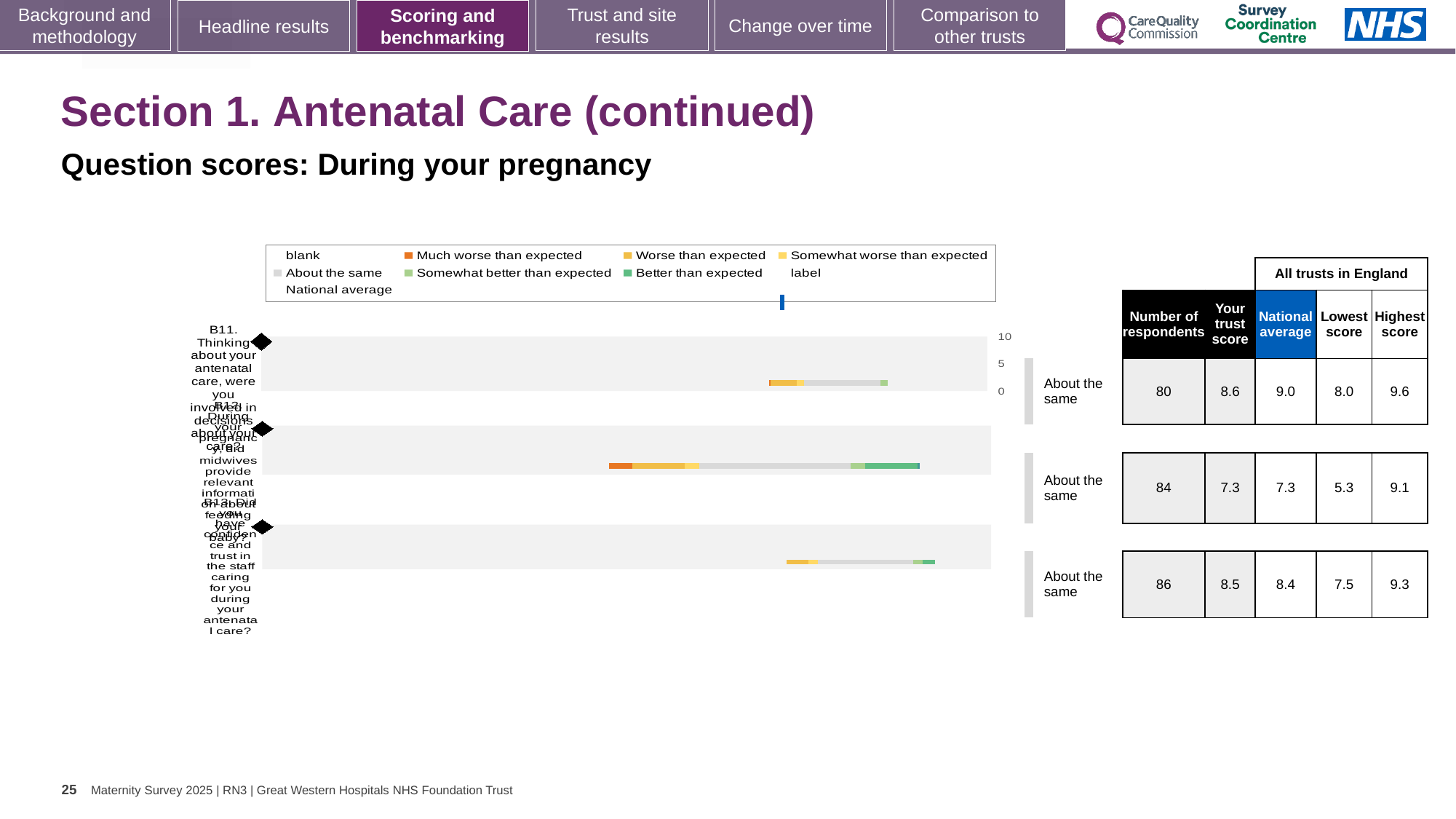
For question B13, which is larger: the trust score or the national average? the trust score What is the difference between the highest score and the lowest score for question B11? 1.6 What colour does the legend use for 'Much worse than expected'? orange What is the 'Your trust score' value for question B11 (involved in decisions about your care)? 8.6 What kind of chart is used to show the question scores on this slide? bar chart How many respondents are listed for question B12 (midwives provide relevant information about feeding your baby)? 84 Which question has the highest 'Your trust score'? B11 What is the difference between the trust score and the lowest score for question B12? 2.0 What is the national average for question B13 (confidence and trust in the staff caring for you)? 8.4 Which question has the lowest 'Lowest score' across all trusts in England? B12 How many questions (bars) are plotted in the chart? 3 What benchmark category is shown next to the bar for question B12? About the same